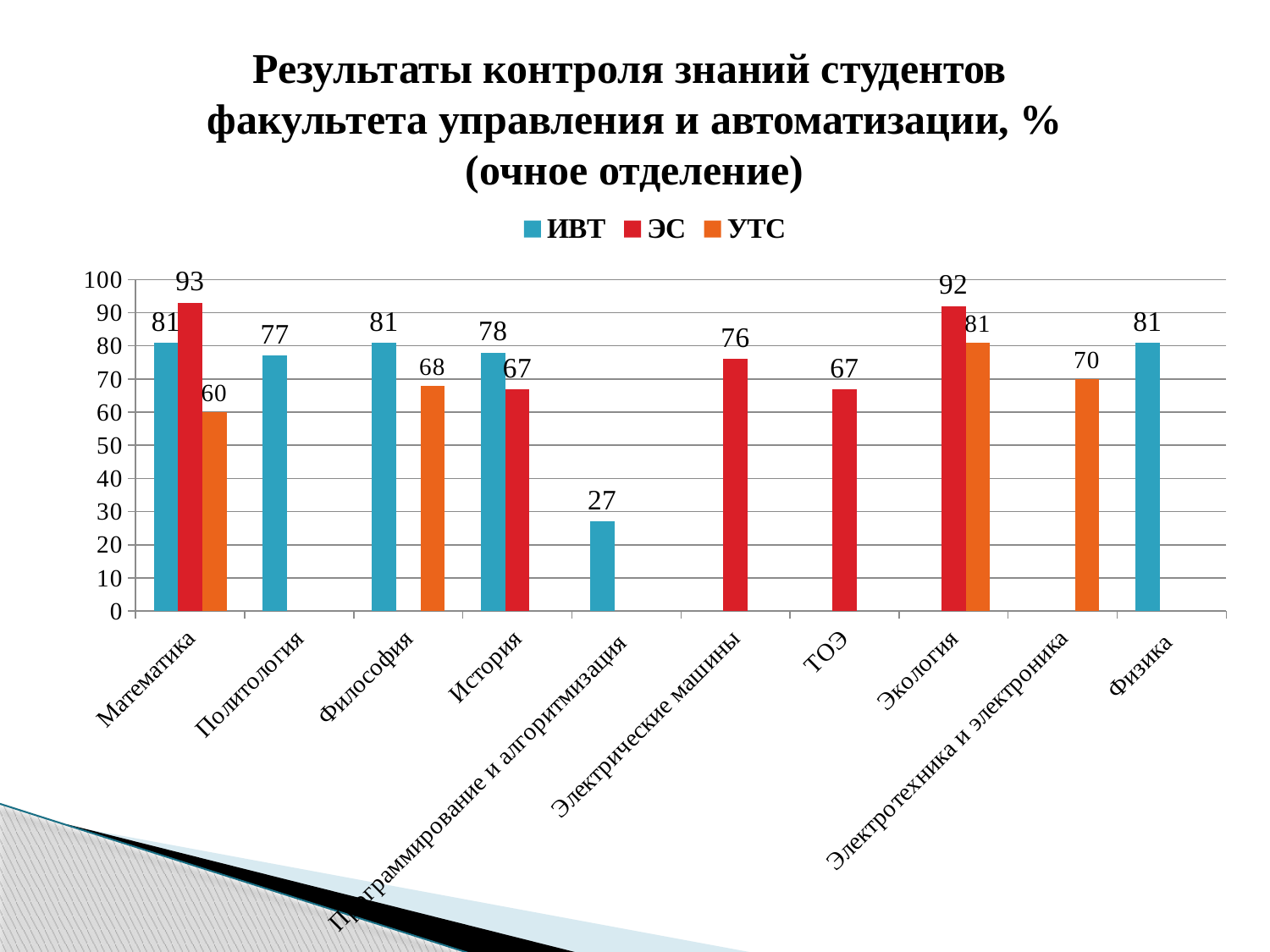
What is the difference between the ЭС and УТС values in Математика? 33 Which is larger: the ИВТ value in История or the ЭС value in История? ИВТ What is the value for ЭС in Экология? 92 Which series is shown in orange in the legend? УТС Which category has the highest ЭС value? Математика What is the value for ИВТ in Программирование и алгоритмизация? 27 What is the value for УТС in Философия? 68 Which category has the lowest ИВТ value? Программирование и алгоритмизация How many categories are shown on the x axis? 10 How many series does the legend list? 3 What is the value for ЭС in Математика? 93 What kind of chart is shown on the slide? bar chart